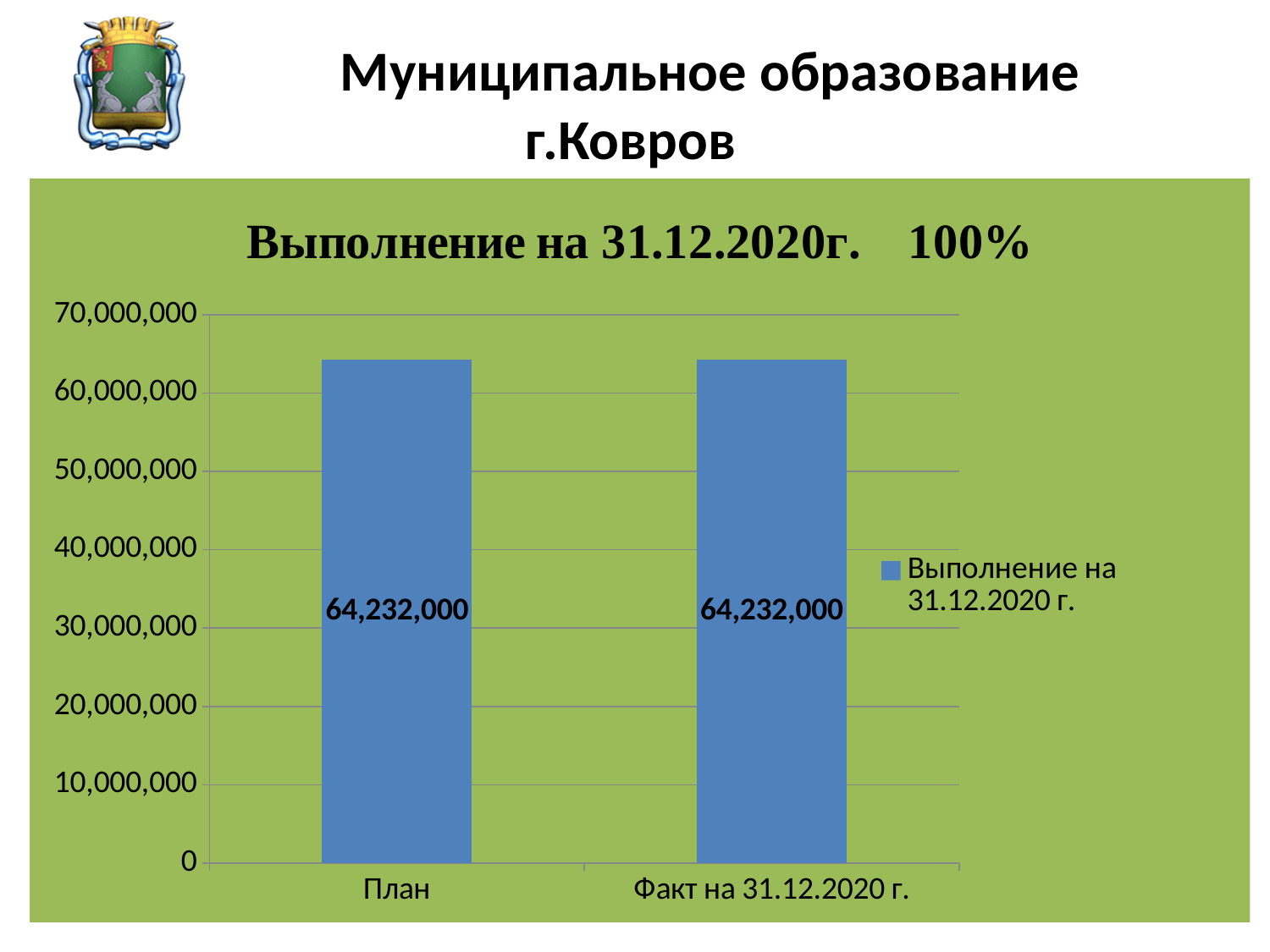
What is the title of the chart? Выполнение на 31.12.2020г. 100% What kind of chart is shown on the slide? bar chart What is the value for Факт на 31.12.2020 г.? 64,232,000 What is the total of the values for План and Факт на 31.12.2020 г.? 128,464,000 Is the value for Факт на 31.12.2020 г. greater or less than 70,000,000? less Is the value for План greater or less than 60,000,000? greater What is the difference between the values for План and Факт на 31.12.2020 г.? 0 How many categories are shown on the x axis? 2 How many series does the legend list? 1 What is the name of the series listed in the legend? Выполнение на 31.12.2020 г. What is the value for План? 64,232,000